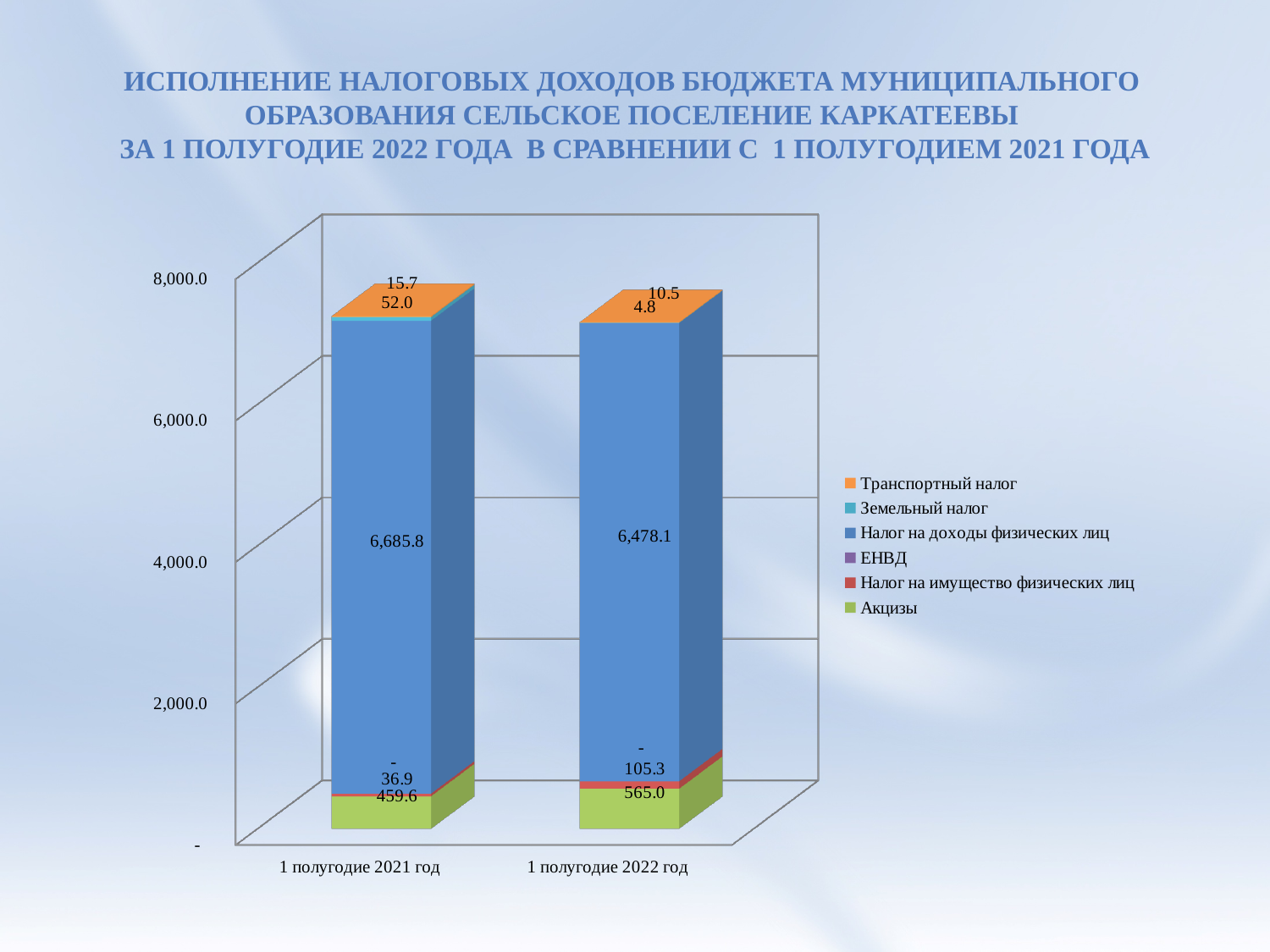
What is the value of Налог на доходы физических лиц for 1 полугодие 2022 год? 6,478.1 What type of chart is shown on the slide? Stacked bar chart What is the difference in Акцизы between 1 полугодие 2022 год and 1 полугодие 2021 год? 105.4 What is the value of Акцизы for 1 полугодие 2022 год? 565.0 Which period has the larger value for Налог на имущество физических лиц? 1 полугодие 2022 год By how much did Налог на доходы физических лиц decrease from 1 полугодие 2021 год to 1 полугодие 2022 год? 207.7 What is the value of Транспортный налог for 1 полугодие 2021 год? 15.7 How many categories (periods) are shown on the x axis? 2 What is the value of Земельный налог for 1 полугодие 2022 год? 4.8 What is the value of Налог на доходы физических лиц for 1 полугодие 2021 год? 6,685.8 Which series is shown in orange in the legend? Транспортный налог How many series does the legend list? 6